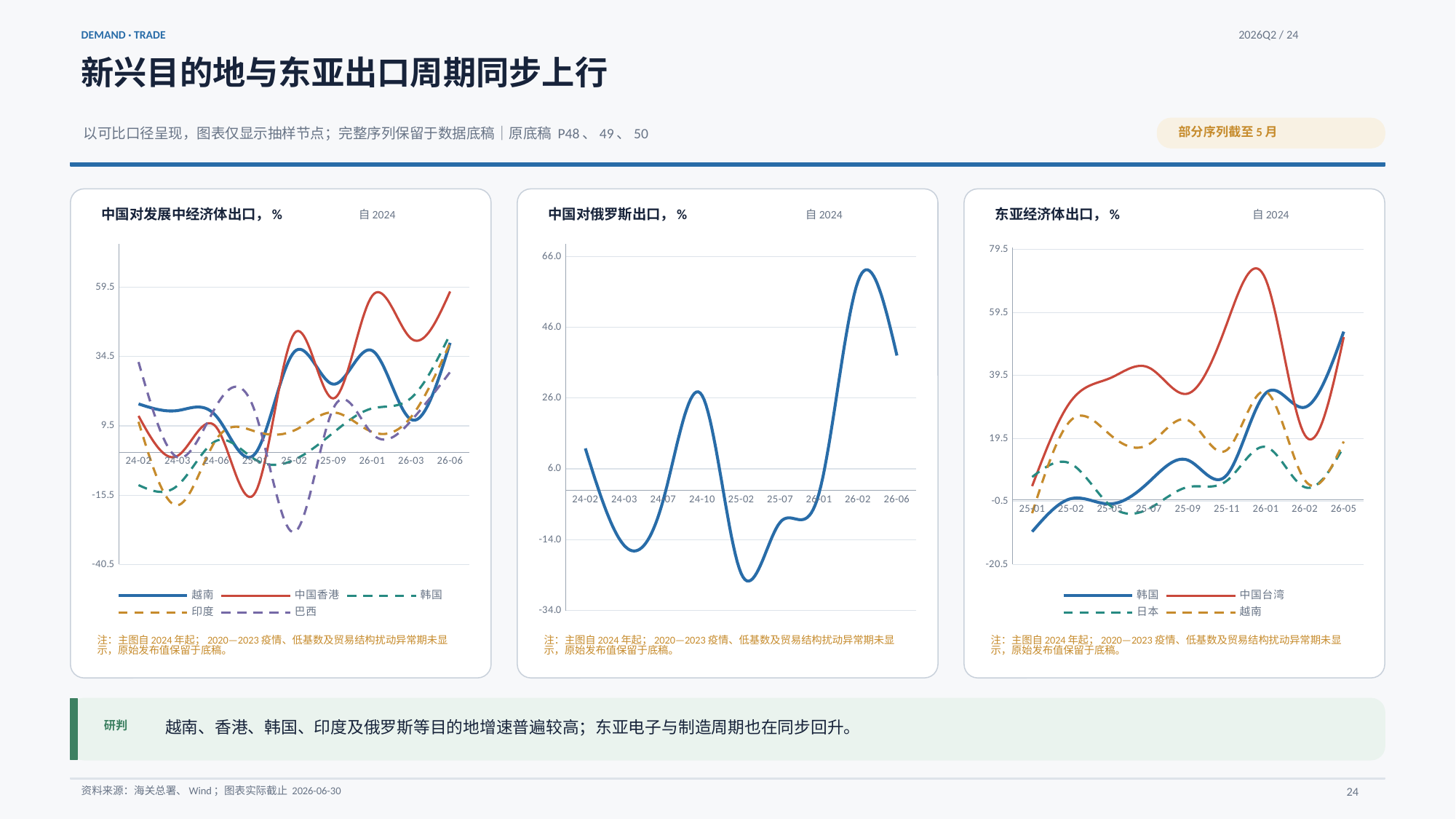
Which series is drawn with a dashed purple line in the chart titled 中国对发展中经济体出口，%? 巴西 In the chart titled 东亚经济体出口，%, is the value for 中国台湾 at 26-01 greater or less than 59.5? greater In the chart titled 中国对发展中经济体出口，%, which is larger at 26-01: 中国香港 or 越南? 中国香港 What kind of chart is the chart titled 中国对俄罗斯出口，%? line chart In the chart titled 东亚经济体出口，%, which series has the highest value at 26-01? 中国台湾 In the chart titled 中国对俄罗斯出口，%, is the value at 26-02 greater or less than 46.0? greater How many x-axis tick labels are shown in the chart titled 中国对俄罗斯出口，%? 9 In the chart titled 中国对俄罗斯出口，%, is the value at 25-02 greater or less than -14.0? less How many series does the legend list in the chart titled 中国对发展中经济体出口，%? 5 In the chart titled 中国对俄罗斯出口，%, does the line rise or fall from 25-07 to 26-02? rise How many series does the legend list in the chart titled 东亚经济体出口，%? 4